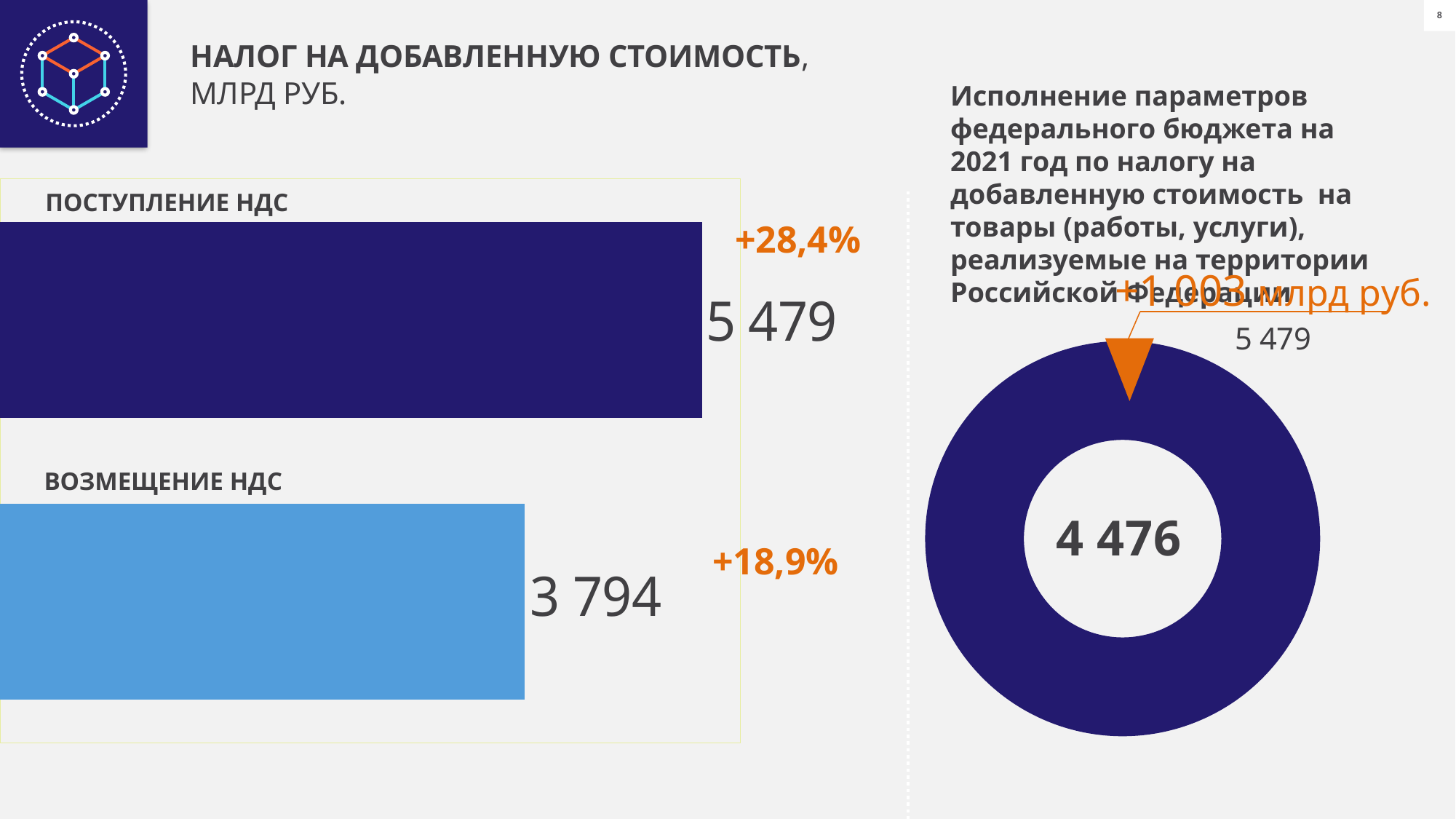
On the bar chart on the left, what is the value for ПОСТУПЛЕНИЕ НДС? 5 479 On the bar chart on the left, what percentage change is shown next to the ВОЗМЕЩЕНИЕ НДС bar? +18,9% On the donut chart on the right, what value is printed in the centre? 4 476 On the bar chart on the left, how many bars are plotted? 2 What kind of chart is shown on the left side of the slide? bar chart On the bar chart on the left, what is the difference between ПОСТУПЛЕНИЕ НДС and ВОЗМЕЩЕНИЕ НДС? 1 685 On the bar chart on the left, which category has the lower value? ВОЗМЕЩЕНИЕ НДС On the bar chart on the left, is the value for ПОСТУПЛЕНИЕ НДС larger or smaller than the value for ВОЗМЕЩЕНИЕ НДС? larger On the bar chart on the left, what is the value for ВОЗМЕЩЕНИЕ НДС? 3 794 On the bar chart on the left, what percentage change is shown next to the ПОСТУПЛЕНИЕ НДС bar? +28,4% What unit is stated in the slide title for the values shown? МЛРД РУБ. On the bar chart on the left, which category has the higher value? ПОСТУПЛЕНИЕ НДС